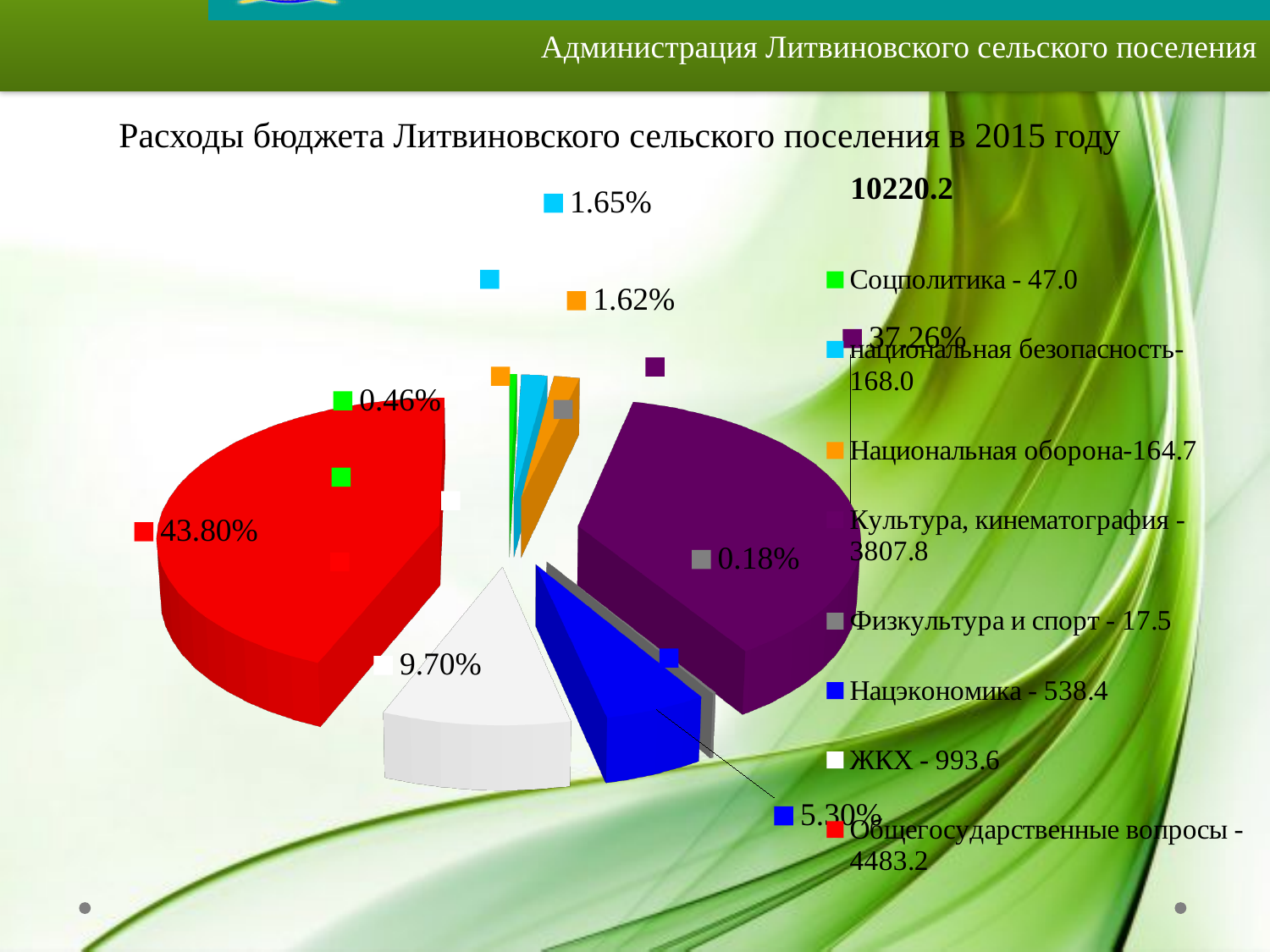
What value is given for ЖКХ in the legend? 993.6 What percentage label is shown for the Нацэкономика slice? 5.30% Which slice is larger, ЖКХ or Нацэкономика? ЖКХ What is the title of the chart on the slide? 10220.2 Which category has the largest slice of the pie? Общегосударственные вопросы What share of the pie does Культура, кинематография take? 37.26% What percentage label is shown for the Соцполитика slice? 0.46% Which category has the smallest slice of the pie? Физкультура и спорт What is the difference in percentage points between the Общегосударственные вопросы slice and the Культура, кинематография slice? 6.54 How many categories does the legend of the pie chart list? 8 What kind of chart is shown on the slide? pie chart